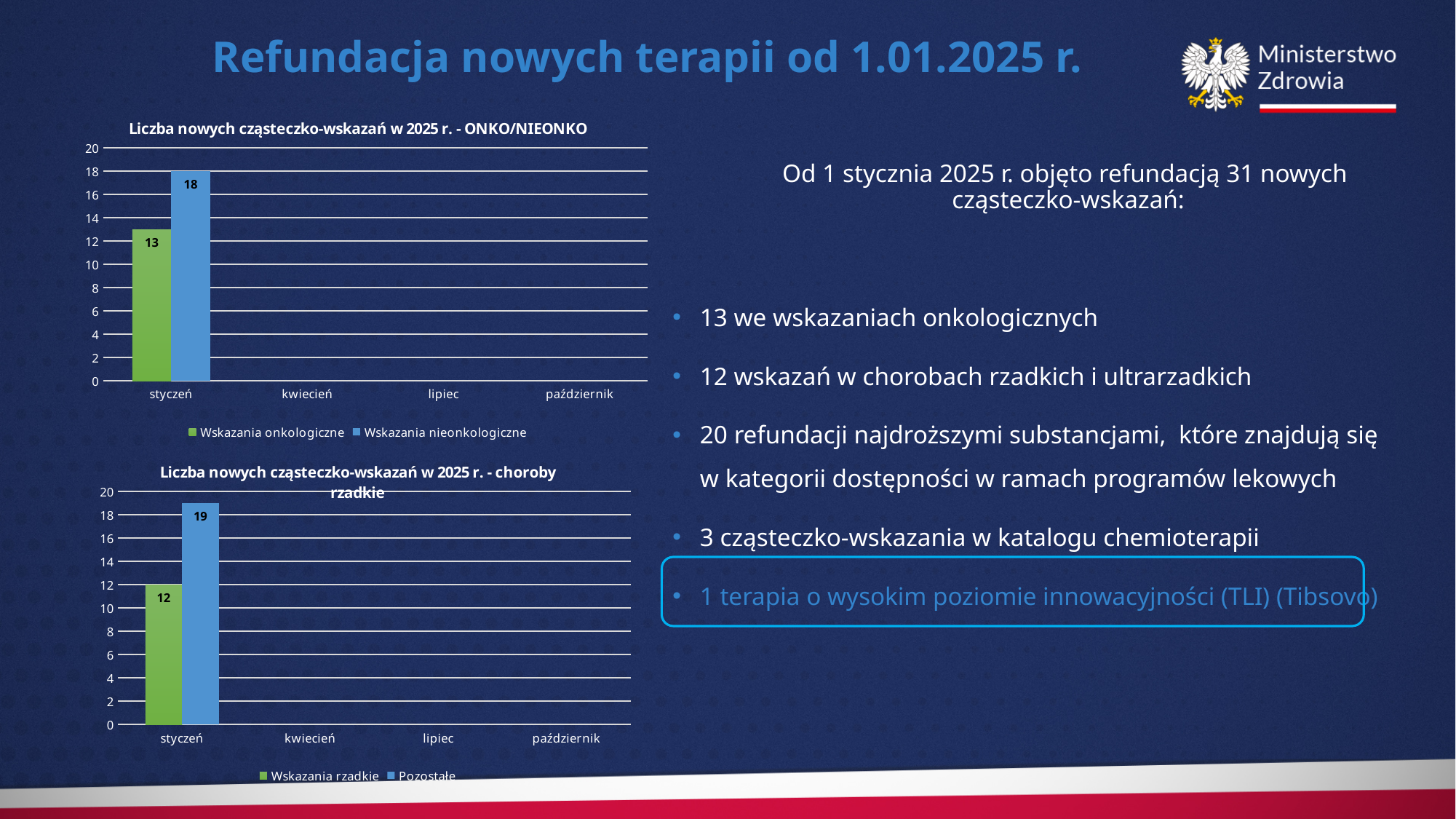
In the top chart (ONKO/NIEONKO), which series has the higher value in styczeń? Wskazania nieonkologiczne In the bottom chart (choroby rzadkie), what is the value for Wskazania rzadkie in styczeń? 12 In the bottom chart (choroby rzadkie), what colour is the Pozostałe series? Blue In the top chart (ONKO/NIEONKO), how many category labels are shown on the x axis? 4 In the top chart (ONKO/NIEONKO), how many series does the legend list? 2 In the bottom chart (choroby rzadkie), what is the difference between Pozostałe and Wskazania rzadkie in styczeń? 7 In the top chart (ONKO/NIEONKO), what is the value for Wskazania onkologiczne in styczeń? 13 In the top chart (ONKO/NIEONKO), what is the value for Wskazania nieonkologiczne in styczeń? 18 In the bottom chart (choroby rzadkie), what is the value for Pozostałe in styczeń? 19 In the top chart (ONKO/NIEONKO), what is the difference between Wskazania nieonkologiczne and Wskazania onkologiczne in styczeń? 5 What kind of chart is the bottom chart (choroby rzadkie)? Bar chart In the bottom chart (choroby rzadkie), which series has the lower value in styczeń? Wskazania rzadkie